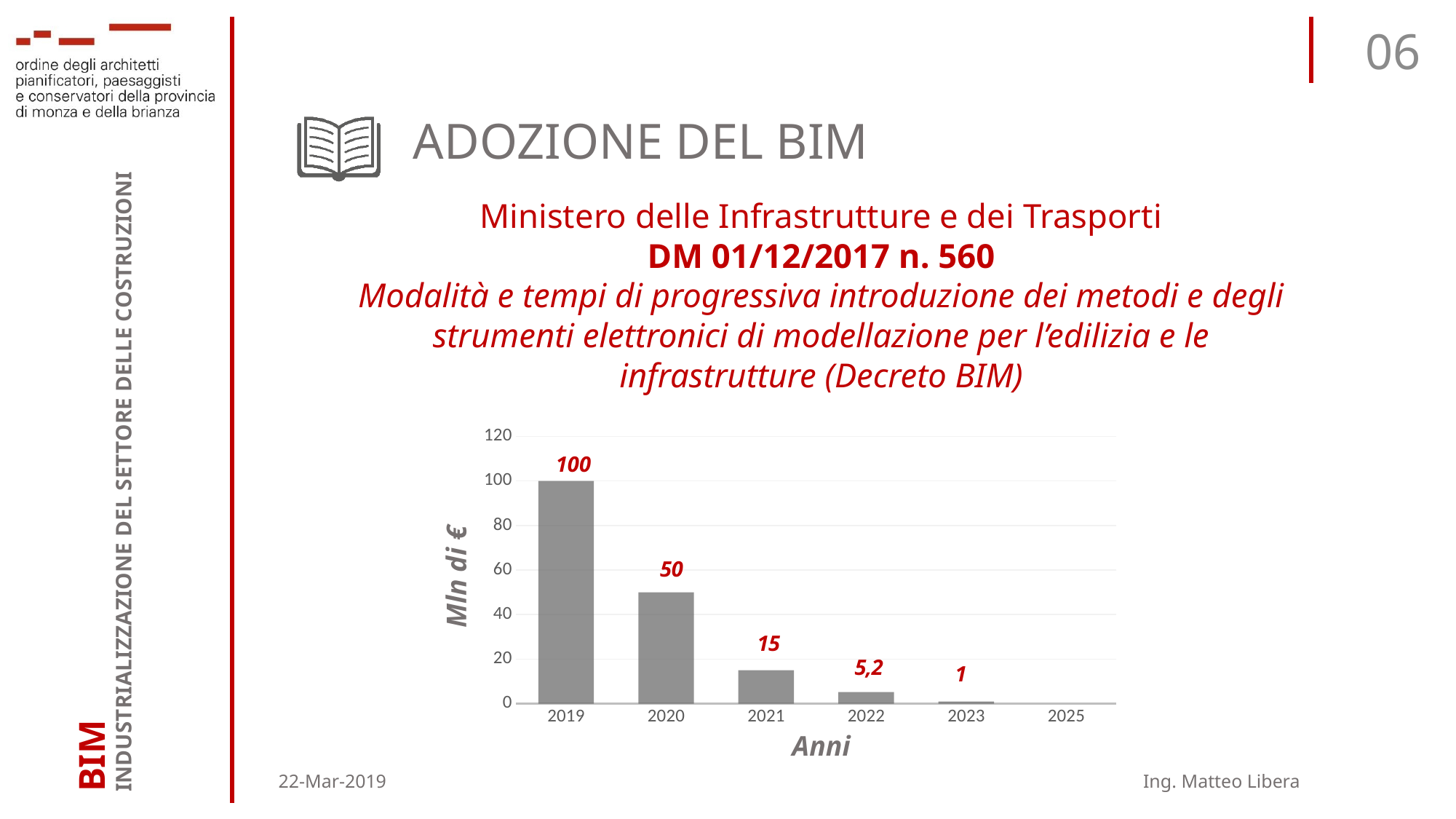
What is the value for 2021? 15 How many years are shown on the x axis? 6 What is the value for 2019? 100 What is the difference between the values for 2019 and 2020? 50 Which is larger, the value for 2021 or the value for 2022? 2021 What is the label of the y axis? Mln di € What is the value for 2023? 1 Do the values rise or fall from 2019 to 2023 along the x axis? fall What type of chart is shown on the slide? bar chart What is the value for 2020? 50 What is the value for 2022? 5,2 Which year has the highest value? 2019